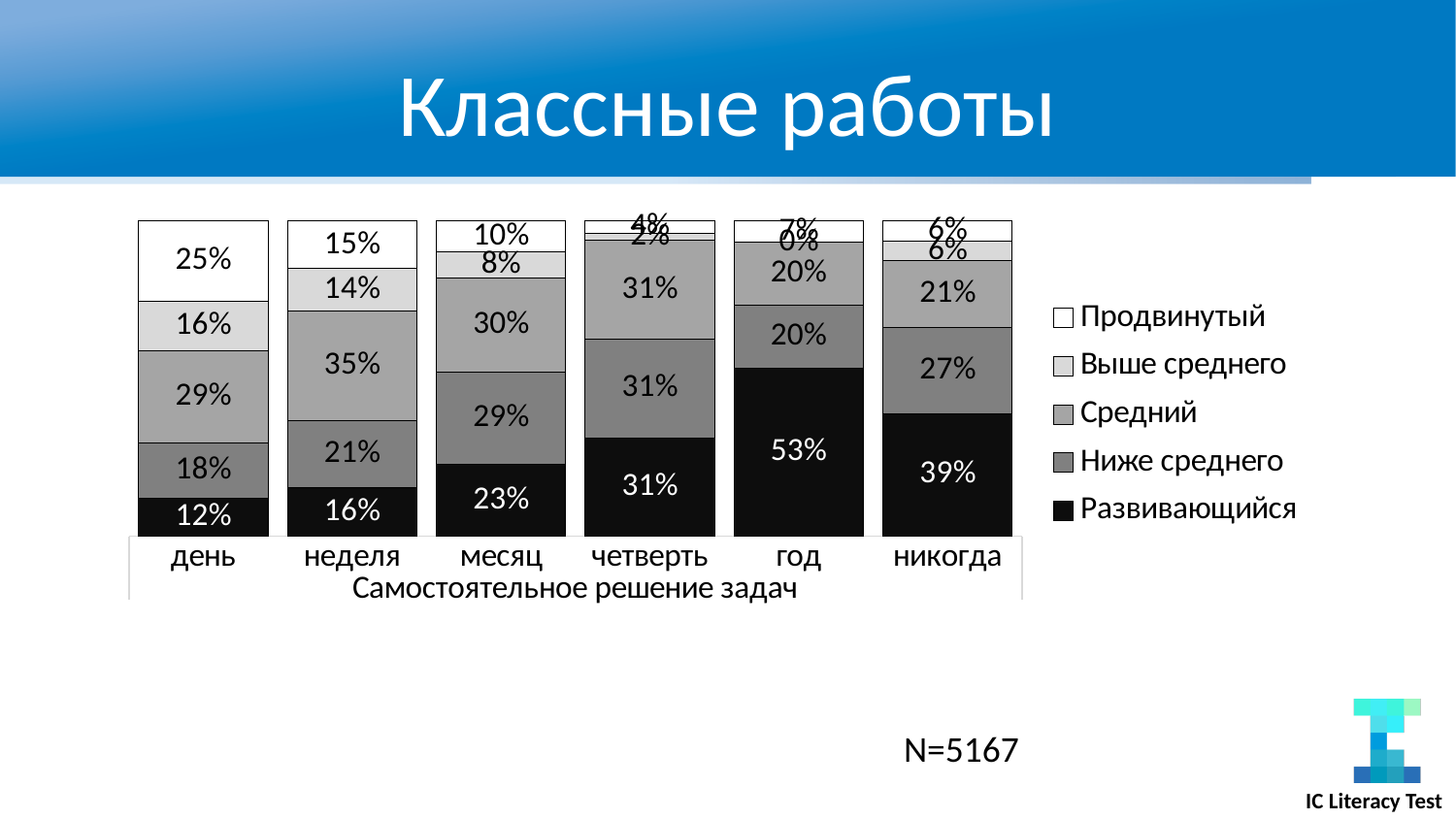
Which is larger: the Средний value for месяц or the Средний value for никогда? месяц What is the value of the Развивающийся series for the category день? 12% How many series does the chart legend list? 5 What kind of chart is shown on the slide? stacked bar chart What is the value of the Средний series for the category неделя? 35% What is the value of the Ниже среднего series for the category никогда? 27% How many categories are shown along the x axis of the chart? 6 Which category has the lowest value for the Развивающийся series? день What is the value of the Развивающийся series for the category год? 53% What is the x-axis title of the chart? Самостоятельное решение задач Which category has the highest value for the Развивающийся series? год What is the difference between the Продвинутый values for день and неделя? 10%